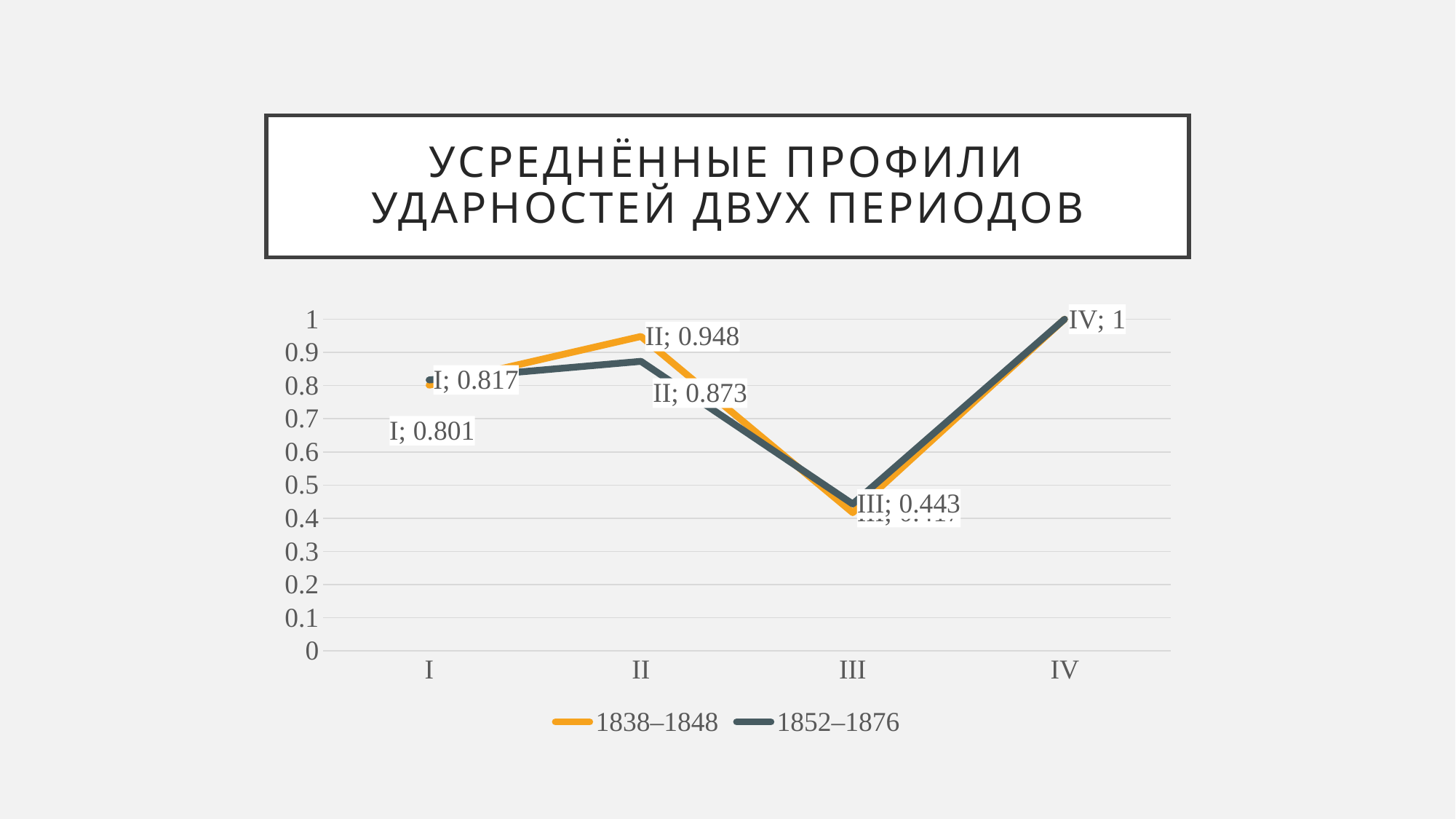
How many series does the legend list? 2 Is the value for the 1838–1848 series at category III greater or less than 0.5? less What is the value for the 1838–1848 series at category II? 0.948 What type of chart is shown on the slide? line chart What is the difference between the 1838–1848 and 1852–1876 values at category II? 0.075 What is the value for the 1852–1876 series at category II? 0.873 What is the value for the 1852–1876 series at category III? 0.443 What is the value at category IV? 1 How many categories are on the x axis? 4 Which category has the lowest value for the 1852–1876 series? III Which category has the highest value for the 1838–1848 series? IV What is the value for the 1852–1876 series at category I? 0.817